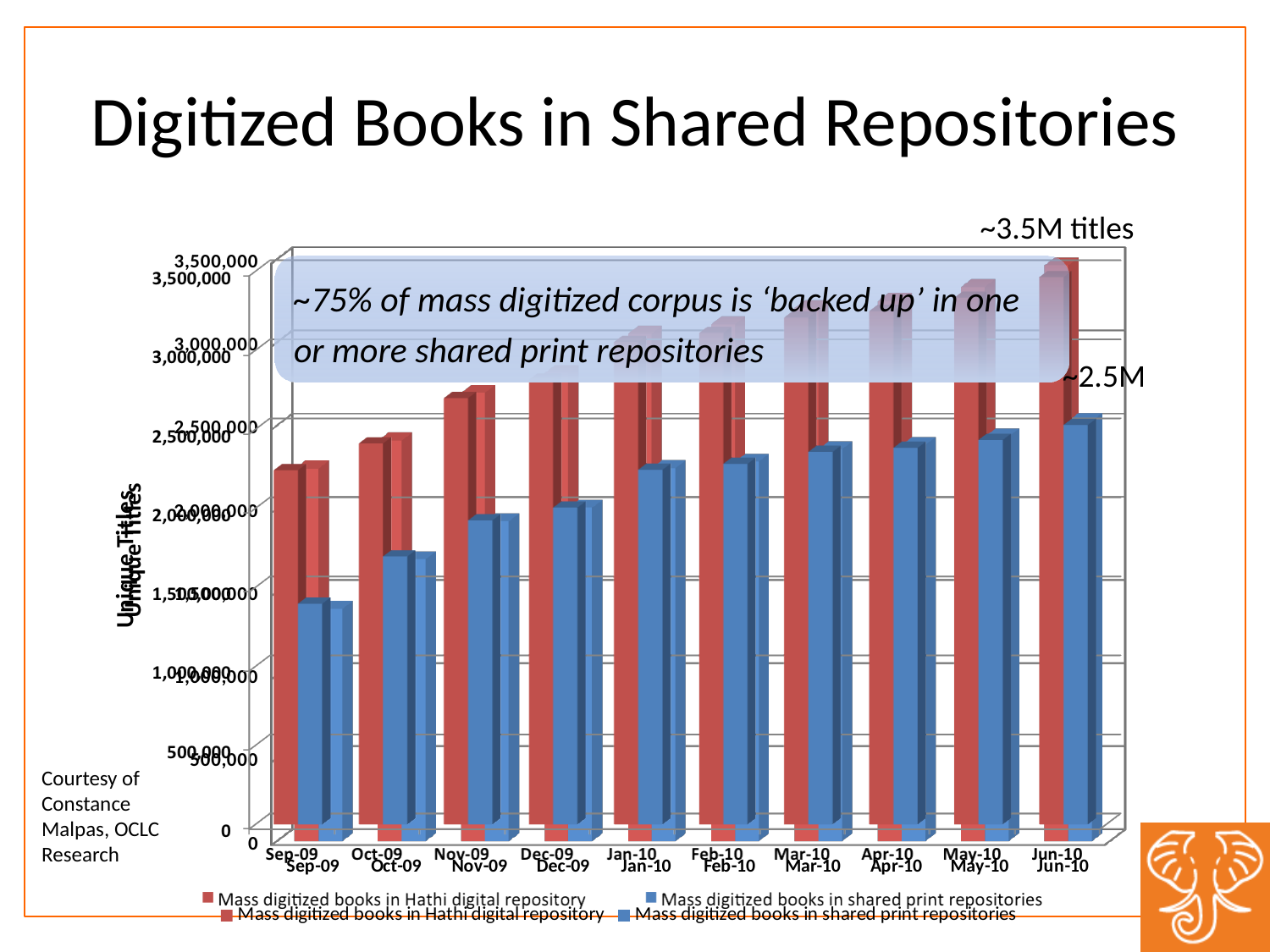
How many months are shown along the x axis of the chart? 10 How many series does the chart legend list? 2 Which month has the lowest value for mass digitized books in Hathi digital repository? Sep-09 What is the title of the chart's vertical axis? Unique Titles Which colour represents mass digitized books in shared print repositories in the chart? blue Is the value for mass digitized books in Hathi digital repository in Mar-10 greater or less than 3,000,000? greater In Sep-09, which is larger: mass digitized books in Hathi digital repository or mass digitized books in shared print repositories? Mass digitized books in Hathi digital repository Which month has the highest value for mass digitized books in shared print repositories? Jun-10 Is the value for mass digitized books in shared print repositories in Sep-09 greater or less than 1,500,000? less Is the value for mass digitized books in Hathi digital repository in Nov-09 greater or less than 2,500,000? greater Do the values for mass digitized books in shared print repositories rise or fall from Sep-09 to Jun-10? rise What kind of chart is shown on the slide? bar chart